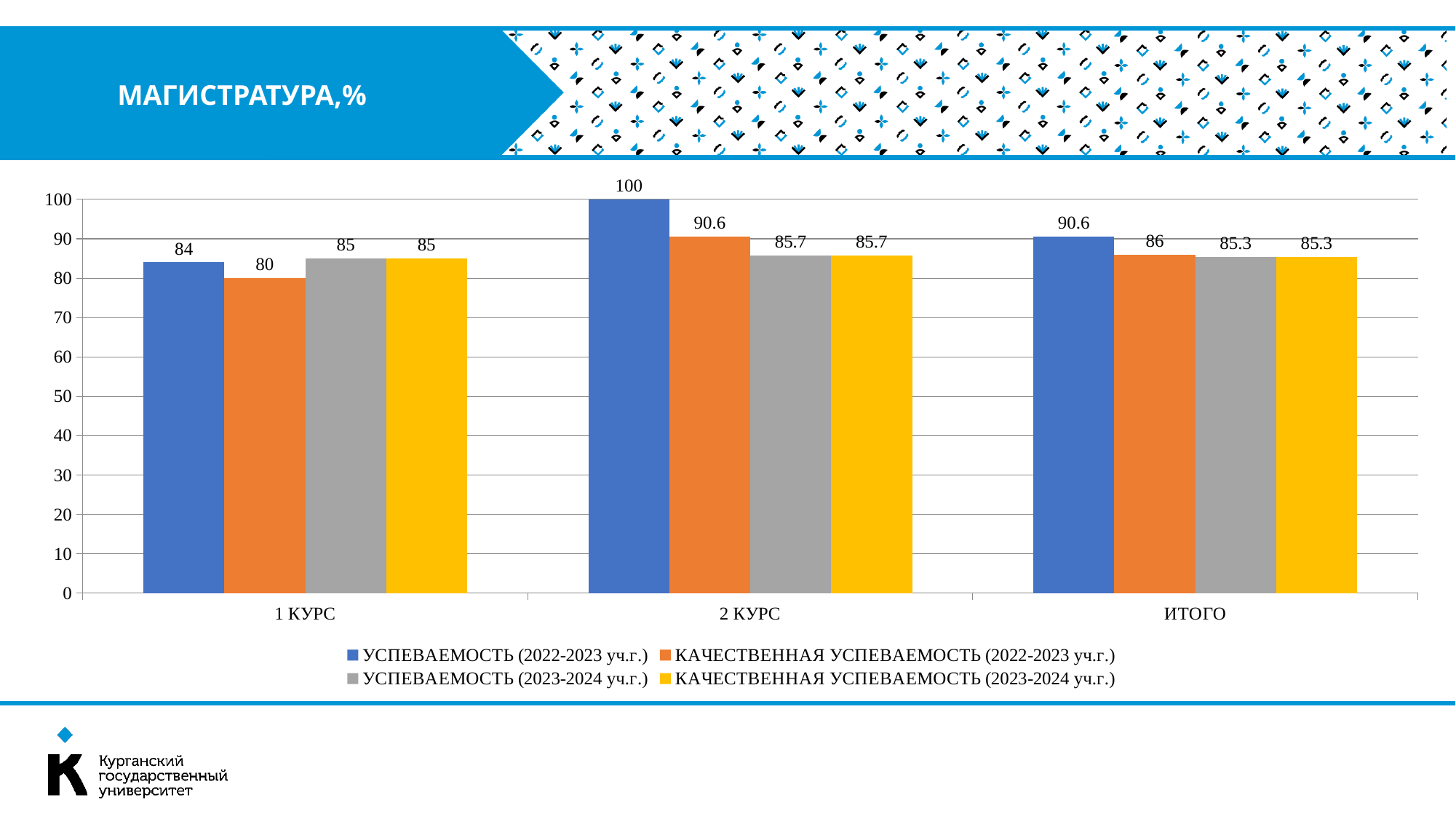
What kind of chart is shown on the slide? Bar chart What is the value of УСПЕВАЕМОСТЬ (2022-2023 уч.г.) for 2 КУРС? 100 What is the value of КАЧЕСТВЕННАЯ УСПЕВАЕМОСТЬ (2023-2024 уч.г.) for 2 КУРС? 85.7 Which category has the highest value for УСПЕВАЕМОСТЬ (2022-2023 уч.г.)? 2 КУРС What is the title of the slide? МАГИСТРАТУРА,% What is the difference between УСПЕВАЕМОСТЬ (2022-2023 уч.г.) and КАЧЕСТВЕННАЯ УСПЕВАЕМОСТЬ (2022-2023 уч.г.) for 2 КУРС? 9.4 What is the value of УСПЕВАЕМОСТЬ (2023-2024 уч.г.) for ИТОГО? 85.3 How many categories are shown on the x axis? 3 Which category has the lowest value for КАЧЕСТВЕННАЯ УСПЕВАЕМОСТЬ (2022-2023 уч.г.)? 1 КУРС How many series does the legend list? 4 For 1 КУРС, which is larger: УСПЕВАЕМОСТЬ (2022-2023 уч.г.) or УСПЕВАЕМОСТЬ (2023-2024 уч.г.)? УСПЕВАЕМОСТЬ (2023-2024 уч.г.) What is the value of КАЧЕСТВЕННАЯ УСПЕВАЕМОСТЬ (2022-2023 уч.г.) for 1 КУРС? 80